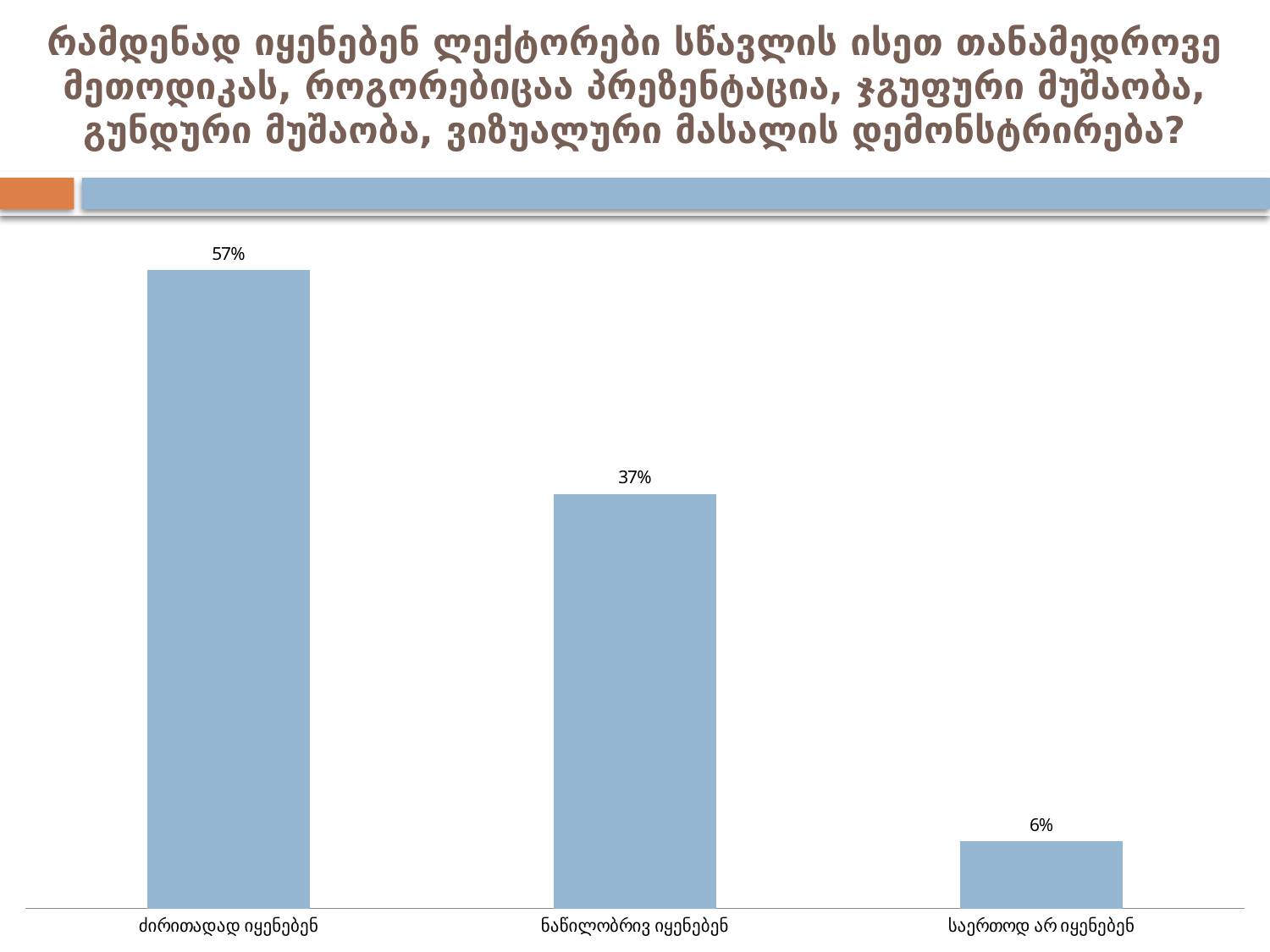
Which is larger, the value for ნაწილობრივ იყენებენ or the value for საერთოდ არ იყენებენ? ნაწილობრივ იყენებენ What is the value for ძირითადად იყენებენ? 57% What is the difference between the values for ნაწილობრივ იყენებენ and საერთოდ არ იყენებენ? 31% What kind of chart is shown on the slide? bar chart What is the value for ნაწილობრივ იყენებენ? 37% Which category has the lowest value? საერთოდ არ იყენებენ What is the difference between the values for ძირითადად იყენებენ and ნაწილობრივ იყენებენ? 20% What is the value for საერთოდ არ იყენებენ? 6% What colour are the bars in the chart? light blue Do the values rise or fall from left to right across the categories? fall How many categories are shown in the chart? 3 Which category has the highest value? ძირითადად იყენებენ